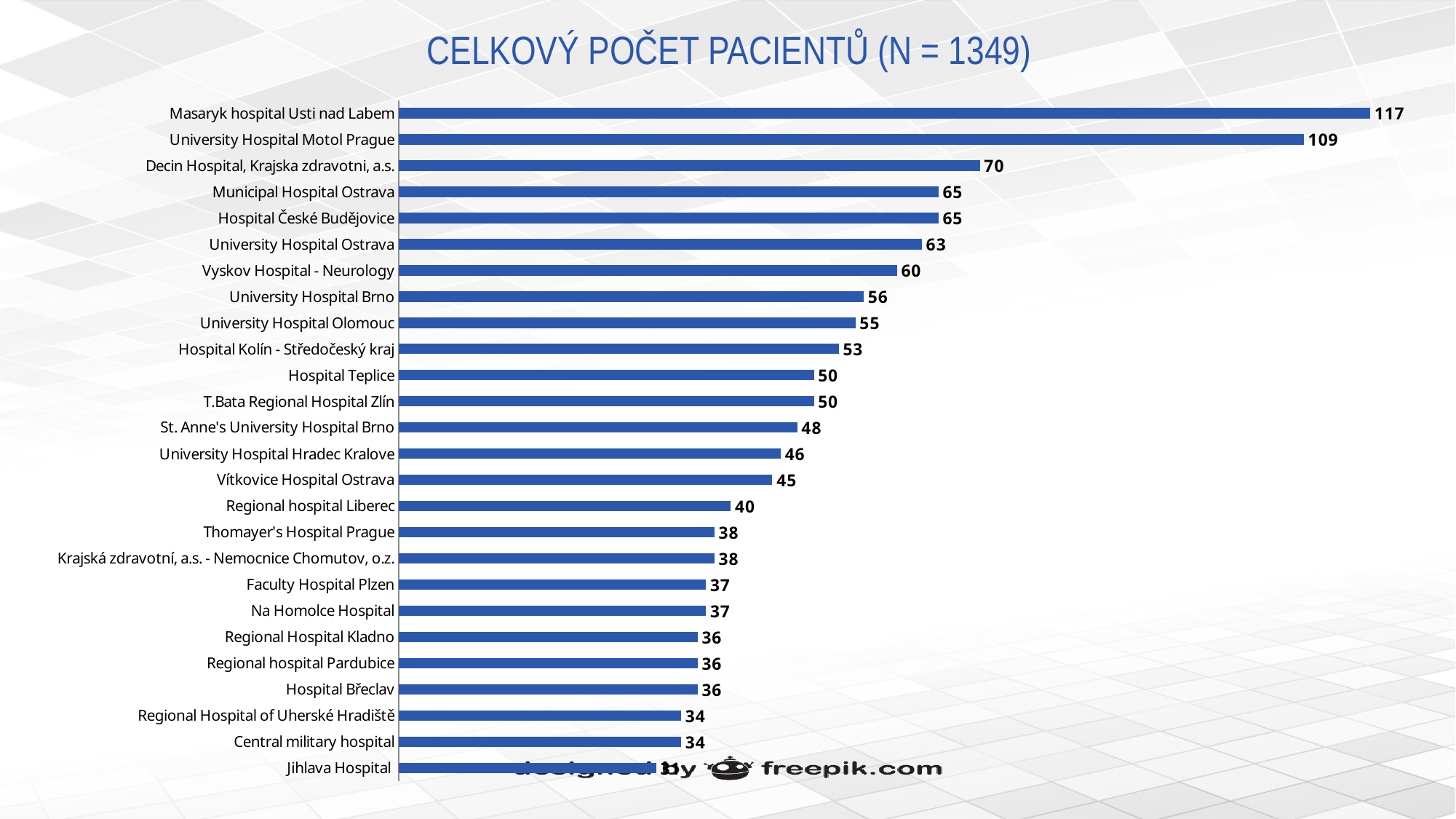
What is the value for University Hospital Olomouc? 55 Which is larger, the value for University Hospital Brno or the value for St. Anne's University Hospital Brno? University Hospital Brno Which hospital has the lowest number of patients? Jihlava Hospital Which hospital has the highest number of patients? Masaryk hospital Usti nad Labem What is the value for Regional hospital Liberec? 40 What is the difference between the values for Vyskov Hospital - Neurology and Hospital Teplice? 10 What is the value for Central military hospital? 34 What is the value for Masaryk hospital Usti nad Labem? 117 What is the title of the chart? CELKOVÝ POČET PACIENTŮ (N = 1349) What kind of chart is shown on the slide? Bar chart How many hospitals are shown in the chart? 26 What is the difference between the values for University Hospital Motol Prague and Decin Hospital, Krajska zdravotni, a.s.? 39